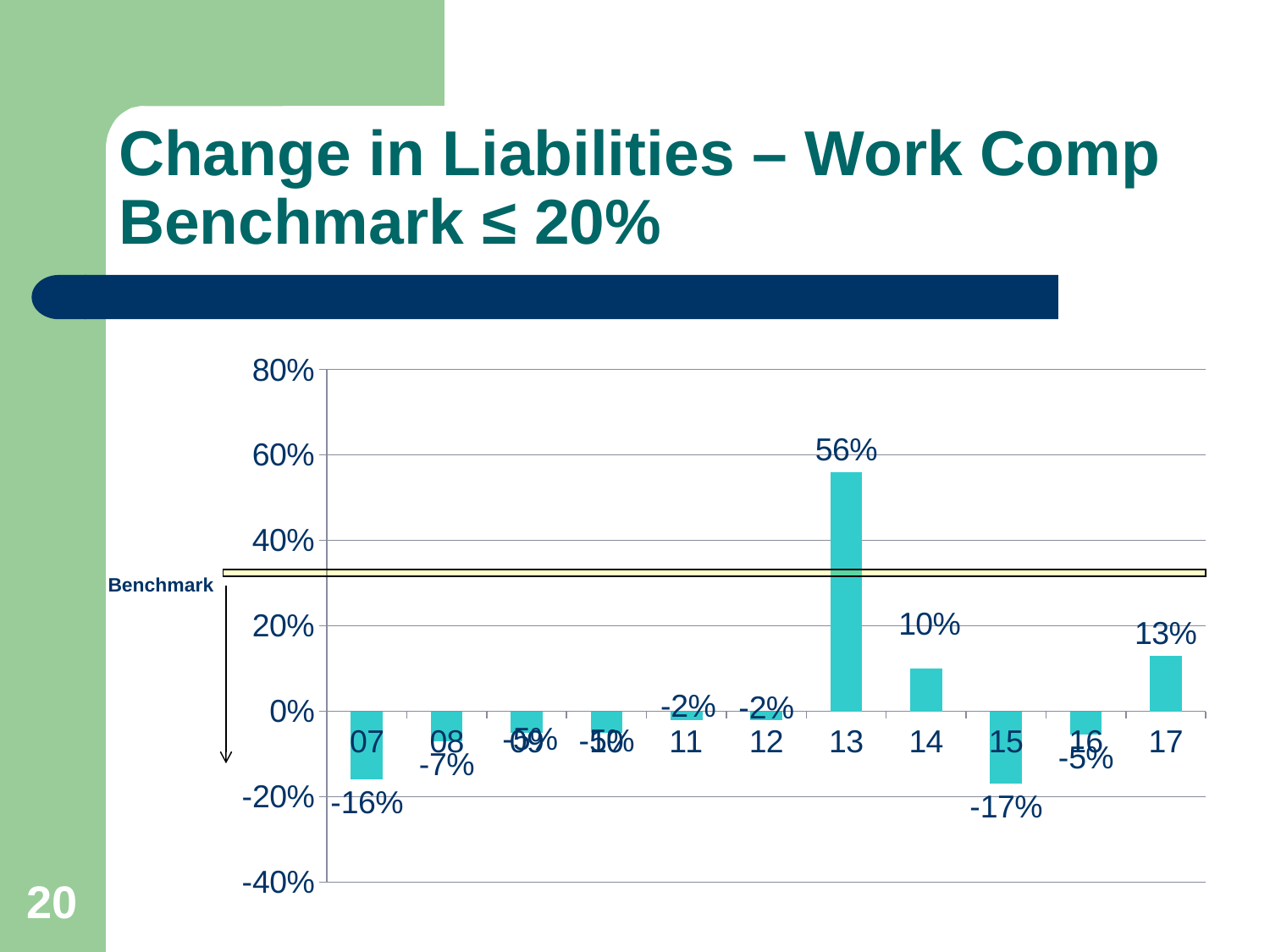
What kind of chart is shown on the slide? bar chart Which is larger, the value for 14 or the value for 17? 17 What is the value for 07? -16% What is the value for 15? -17% How many years are shown on the x axis? 11 Which year has the highest value? 13 What is the value for 17? 13% What is the value for 14? 10% Which year has the lowest value? 15 What is the difference between the values for 13 and 14? 46 percentage points Is the value for 13 greater or less than 40%? greater What is the value for 13? 56%